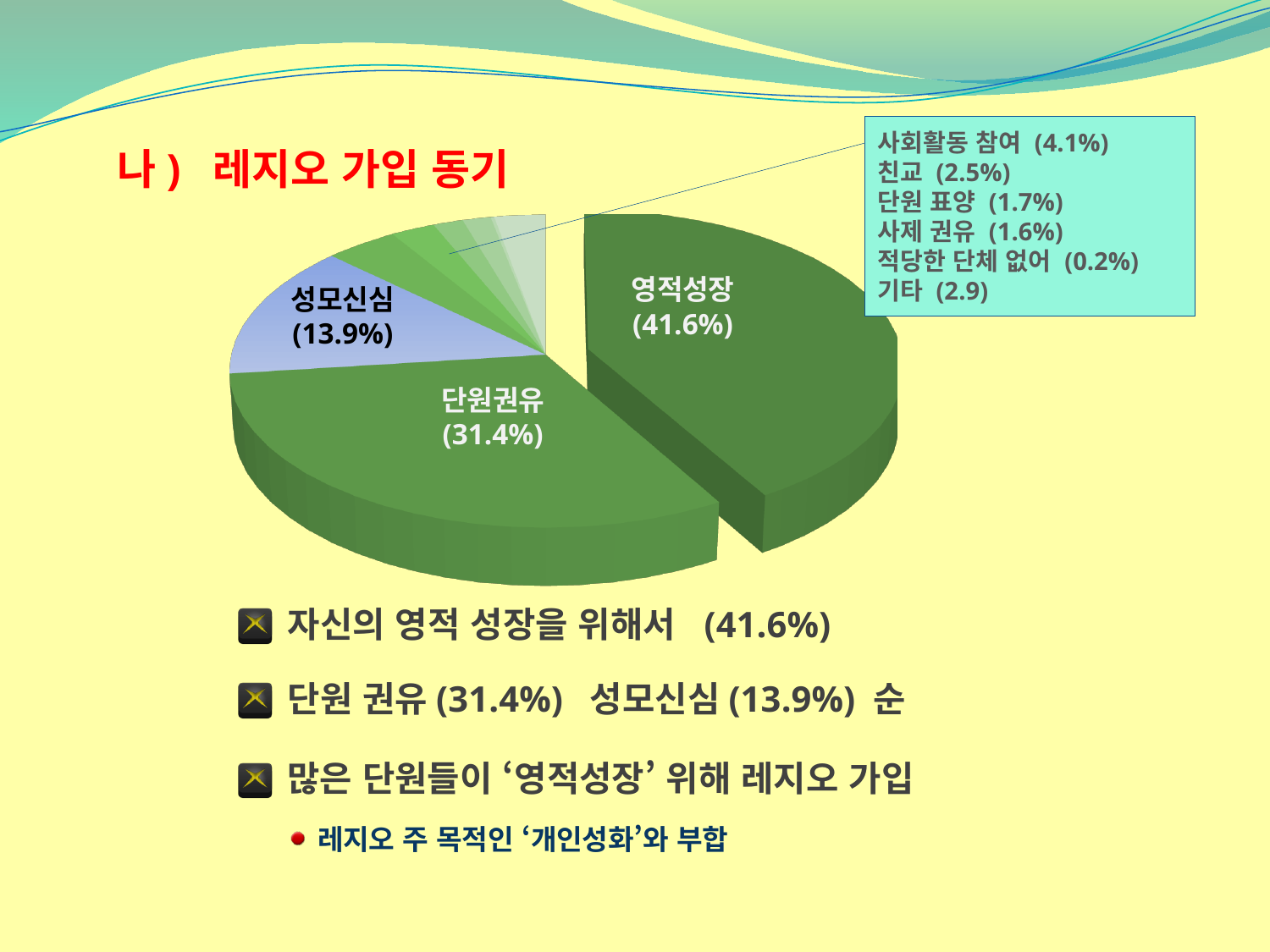
What kind of chart is shown on the slide? Pie chart What is the title of the chart on the slide? 나) 레지오 가입 동기 What value is given for 적당한 단체 없어 in the callout box? 0.2% Which category has the largest slice of the pie? 영적성장 What share of the pie does 단원권유 represent? 31.4% What value is given for 사회활동 참여 in the callout box? 4.1% What share of the pie does 영적성장 represent? 41.6% Which is larger, the share for 단원권유 or the share for 성모신심? 단원권유 Which category has the smallest share in the chart? 적당한 단체 없어 How many categories are shown in the pie chart, including those listed in the callout box? 9 What is the difference in percentage points between 영적성장 and 단원권유? 10.2 What share of the pie does 성모신심 represent? 13.9%